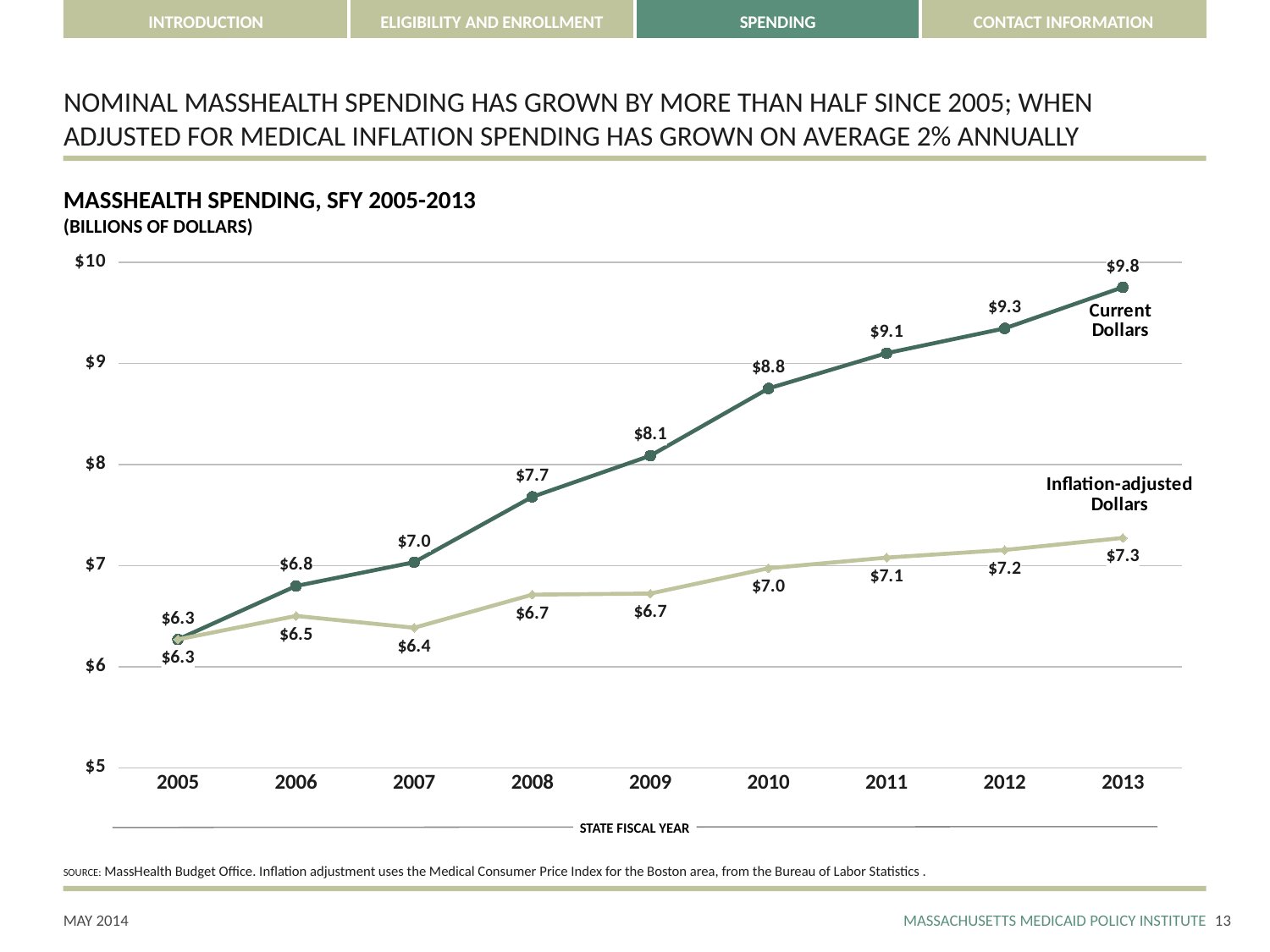
Which is larger in 2008: the Current Dollars value or the Inflation-adjusted Dollars value? Current Dollars What is the Inflation-adjusted Dollars value for 2010? $7.0 How many years are plotted on the x axis? 9 How many series are plotted on the chart? 2 What is the title of the chart? MASSHEALTH SPENDING, SFY 2005-2013 In which year is the Current Dollars value lowest? 2005 What is the difference between the Current Dollars and Inflation-adjusted Dollars values in 2013? $2.5 What type of chart is shown on the slide? Line chart What is the Current Dollars value for 2013? $9.8 In which year is the Current Dollars value highest? 2013 Does the Current Dollars series rise or fall from 2005 to 2013? Rise What is the Current Dollars value for 2009? $8.1